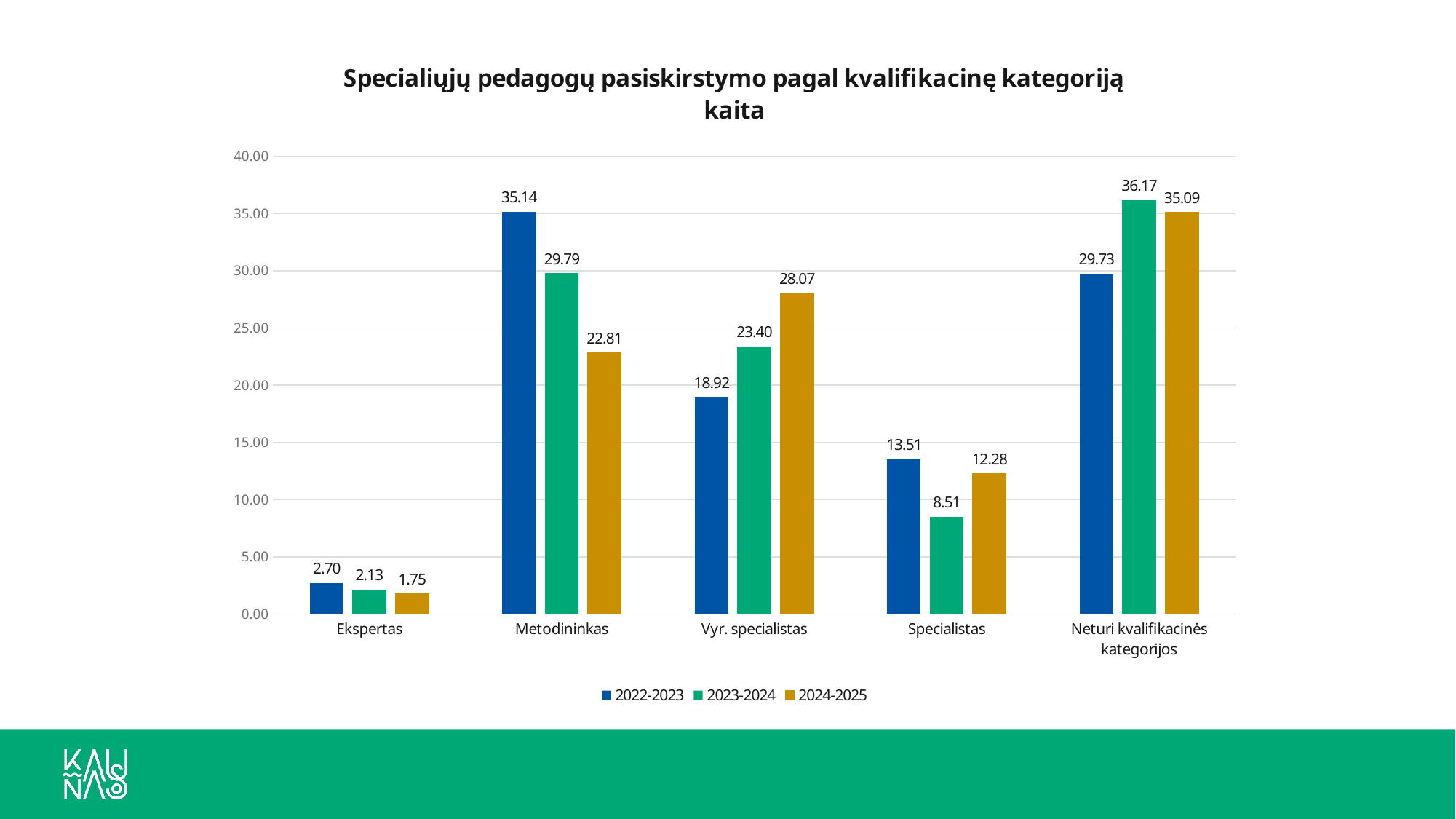
How many categories are shown on the x axis? 5 What kind of chart is shown on the slide? Bar chart Which category has the lowest value in the 2024-2025 series? Ekspertas What is the value for Vyr. specialistas in the 2024-2025 series? 28.07 Does the value for Metodininkas rise or fall from 2022-2023 to 2024-2025? Fall Which category has the highest value in the 2023-2024 series? Neturi kvalifikacinės kategorijos What is the difference between the 2022-2023 and 2024-2025 values for Metodininkas? 12.33 Which is larger for Vyr. specialistas: the 2022-2023 value or the 2023-2024 value? 2023-2024 What is the value for Metodininkas in the 2022-2023 series? 35.14 How many series does the legend list? 3 What is the value for Specialistas in the 2023-2024 series? 8.51 What colour represents the 2024-2025 series? Gold